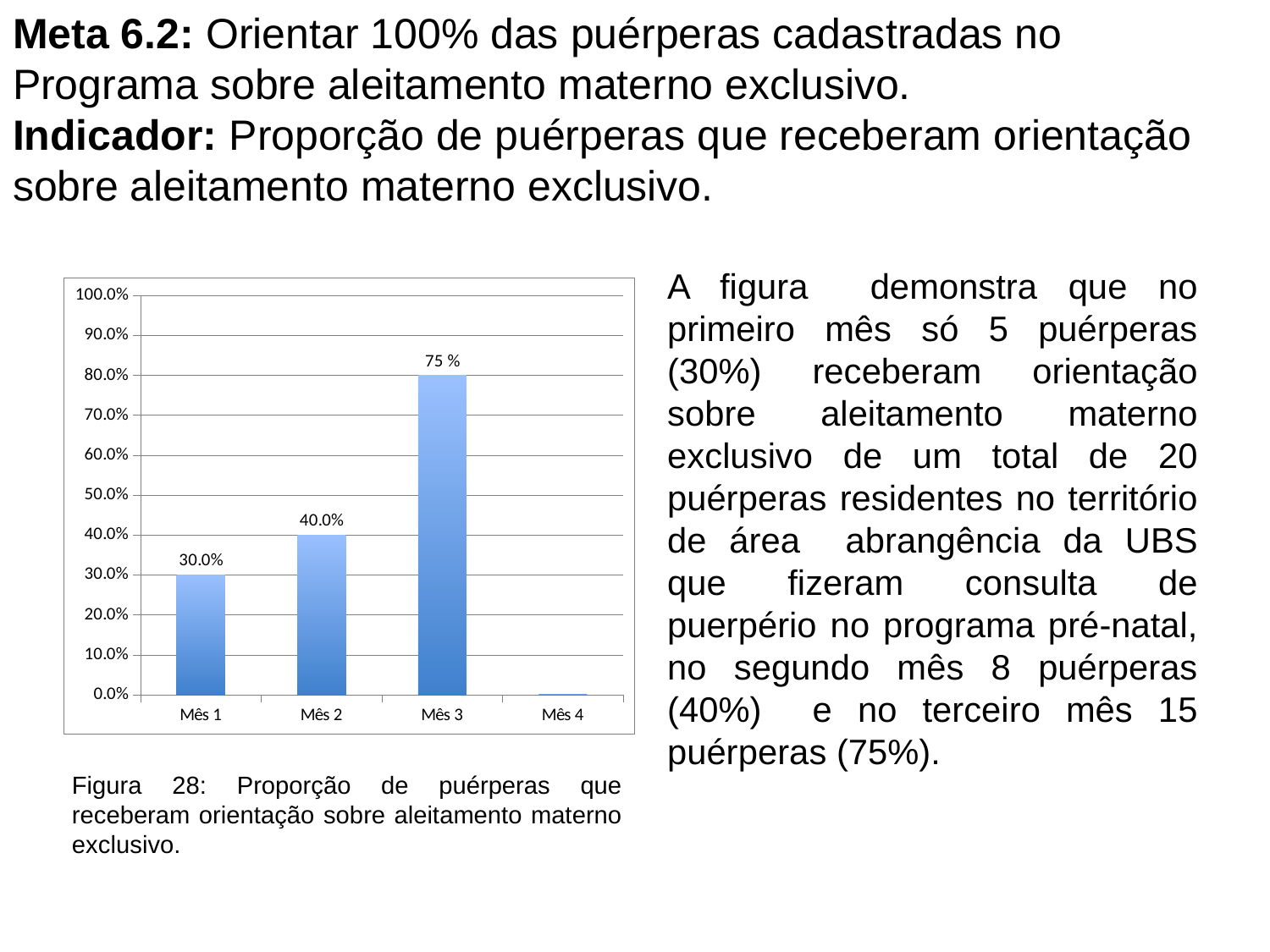
Is the value for Mês 3 greater or less than 60.0%? greater Which month has the lowest bar? Mês 4 What data label is shown on the bar for Mês 3? 75 % Do the values rise or fall from Mês 1 to Mês 3? rise What is the difference between the values for Mês 2 and Mês 1? 10.0% Is the value for Mês 4 greater or less than 10.0%? less What kind of chart is shown on the slide? bar chart Which is larger, the value for Mês 1 or the value for Mês 2? Mês 2 What value is shown for Mês 1? 30.0% How many months are shown on the x axis? 4 Which month has the highest bar? Mês 3 What value is shown for Mês 2? 40.0%